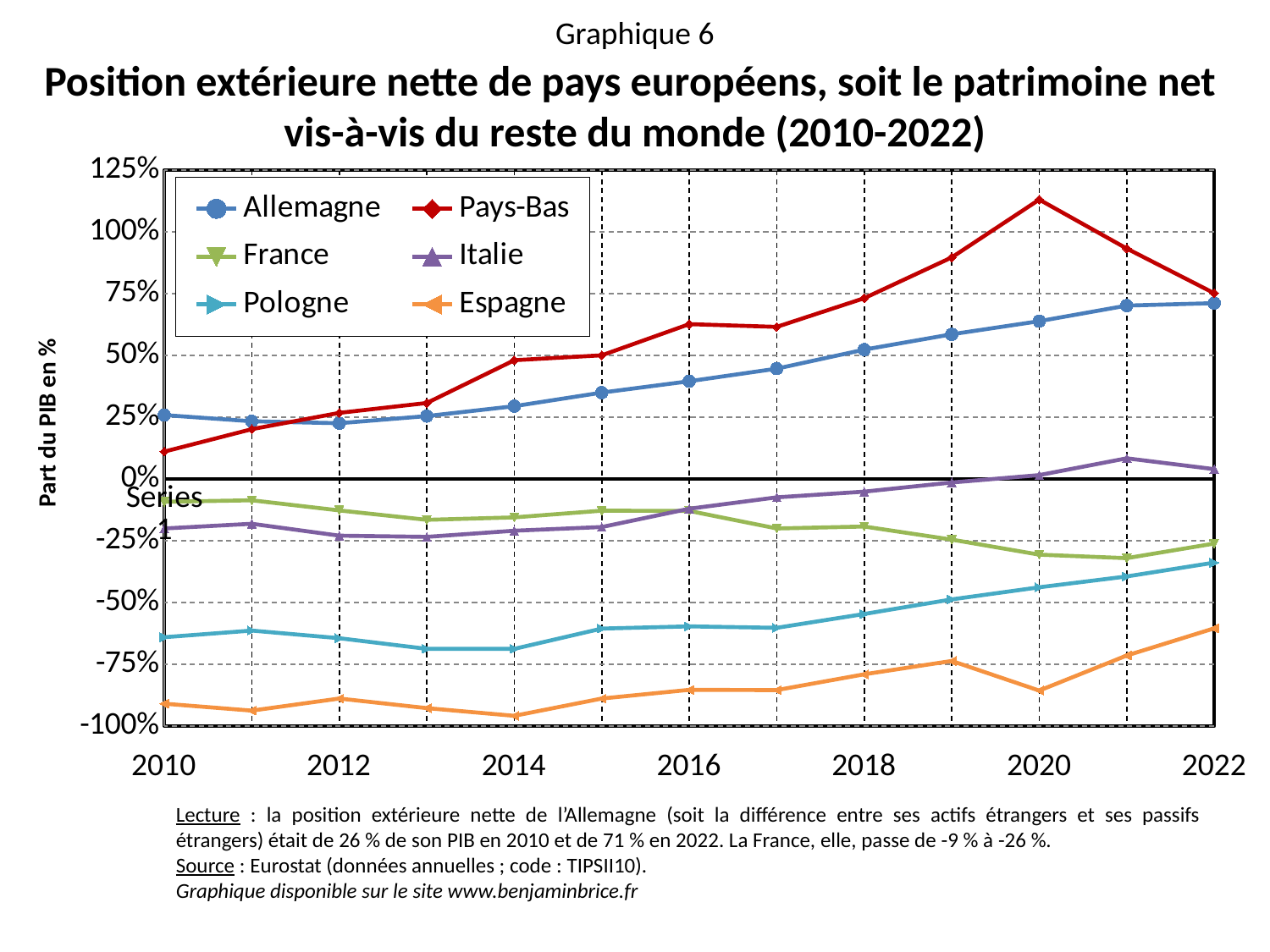
What kind of chart is shown on the slide? line chart According to the slide, what was France's net external position as a share of GDP in 2022? -26 % According to the slide, what was Allemagne's net external position as a share of GDP in 2010? 26 % In 2016, which is higher: the value for Pologne or the value for Espagne? Pologne By how many percentage points did Allemagne's value increase between 2010 and 2022? 45 points How many years (data points per series) are plotted on the x axis? 13 Does the Allemagne line rise or fall overall from 2010 to 2022? rise Which country has the highest value in 2020? Pays-Bas Which country has the lowest value in 2010? Espagne How many series does the legend list? 6 Is the value for Pays-Bas in 2020 greater or less than 100%? greater According to the slide, what was Allemagne's net external position as a share of GDP in 2022? 71 %